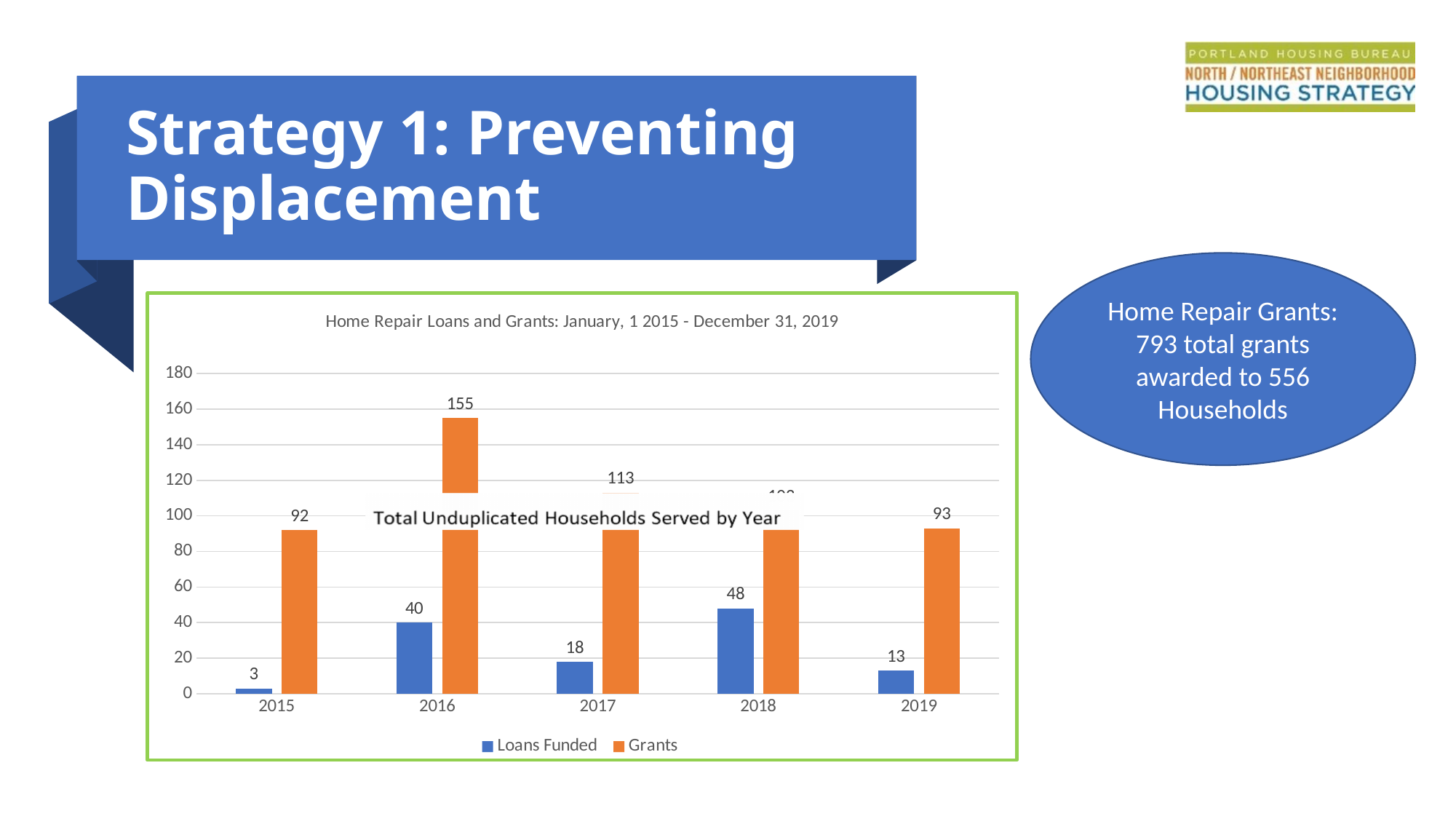
What is the value for Grants in 2015? 92 How many years are shown on the x axis? 5 In which year were Loans Funded highest? 2018 What is the value for Grants in 2016? 155 What is the difference between Loans Funded in 2018 and Loans Funded in 2015? 45 Which year had more Loans Funded, 2017 or 2019? 2017 What is the value for Loans Funded in 2019? 13 How many series does the legend list? 2 In which year were Grants highest? 2016 In which year were Loans Funded lowest? 2015 What is the value for Loans Funded in 2016? 40 What kind of chart is shown on the slide? bar chart